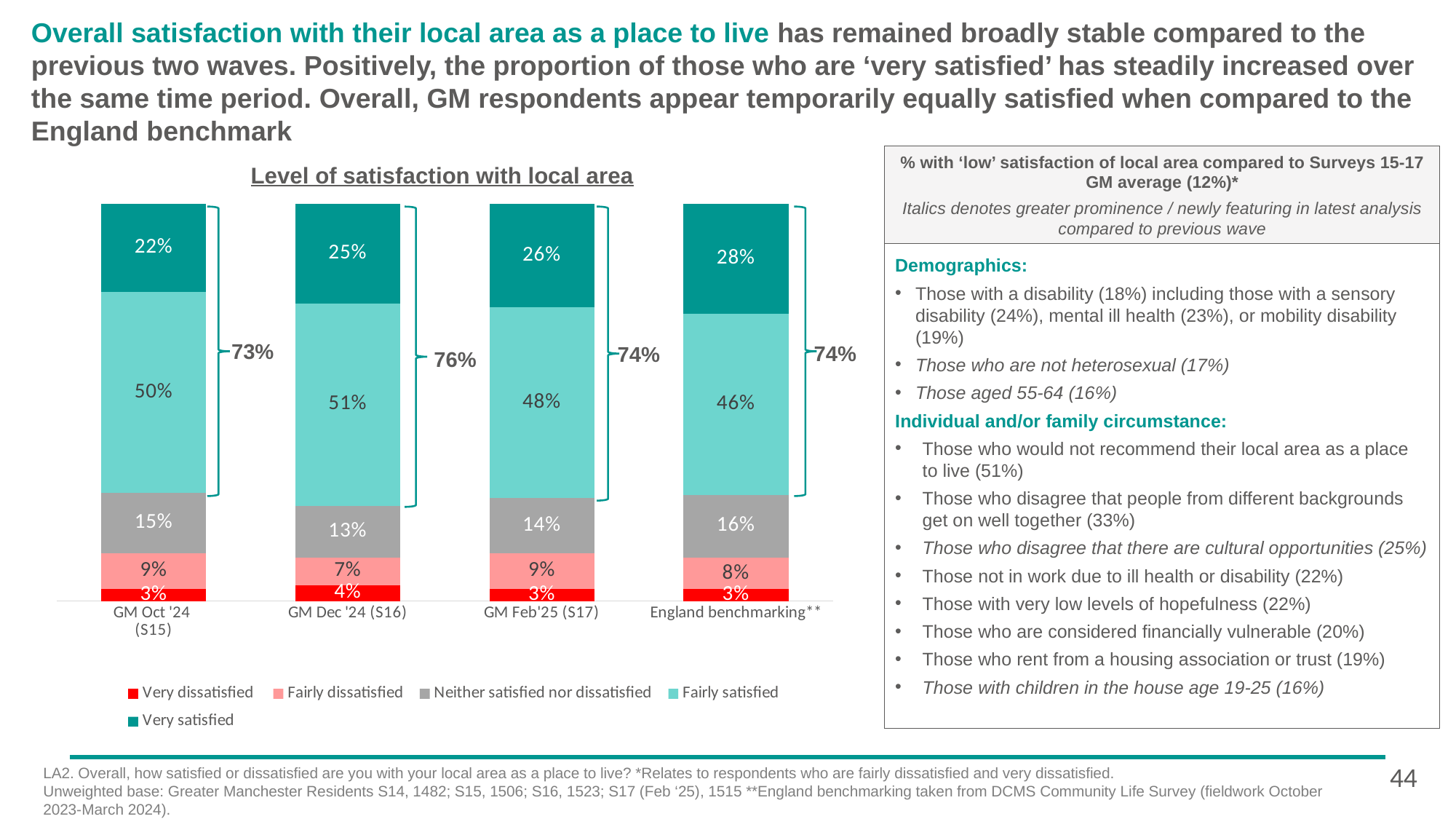
What is the difference between the 'Fairly satisfied' values for GM Oct '24 (S15) and GM Feb'25 (S17)? 2% What percentage of GM Dec '24 (S16) respondents are neither satisfied nor dissatisfied? 13% Which bar has the highest 'Very satisfied' percentage? England benchmarking Which is larger: the 'Neither satisfied nor dissatisfied' value for GM Oct '24 (S15) or for England benchmarking? England benchmarking How many series does the legend list? 5 What combined satisfied percentage is shown by the bracket for GM Dec '24 (S16)? 76% What kind of chart is shown on the slide? Stacked bar chart Does the 'Very satisfied' percentage rise or fall across the three GM waves from Oct '24 to Feb'25? Rise How many bars are shown in the chart? 4 What is the 'Fairly satisfied' value for the England benchmarking bar? 46% What percentage of GM Feb'25 (S17) respondents are very satisfied with their local area? 26% Which bar has the lowest 'Fairly dissatisfied' percentage? GM Dec '24 (S16)